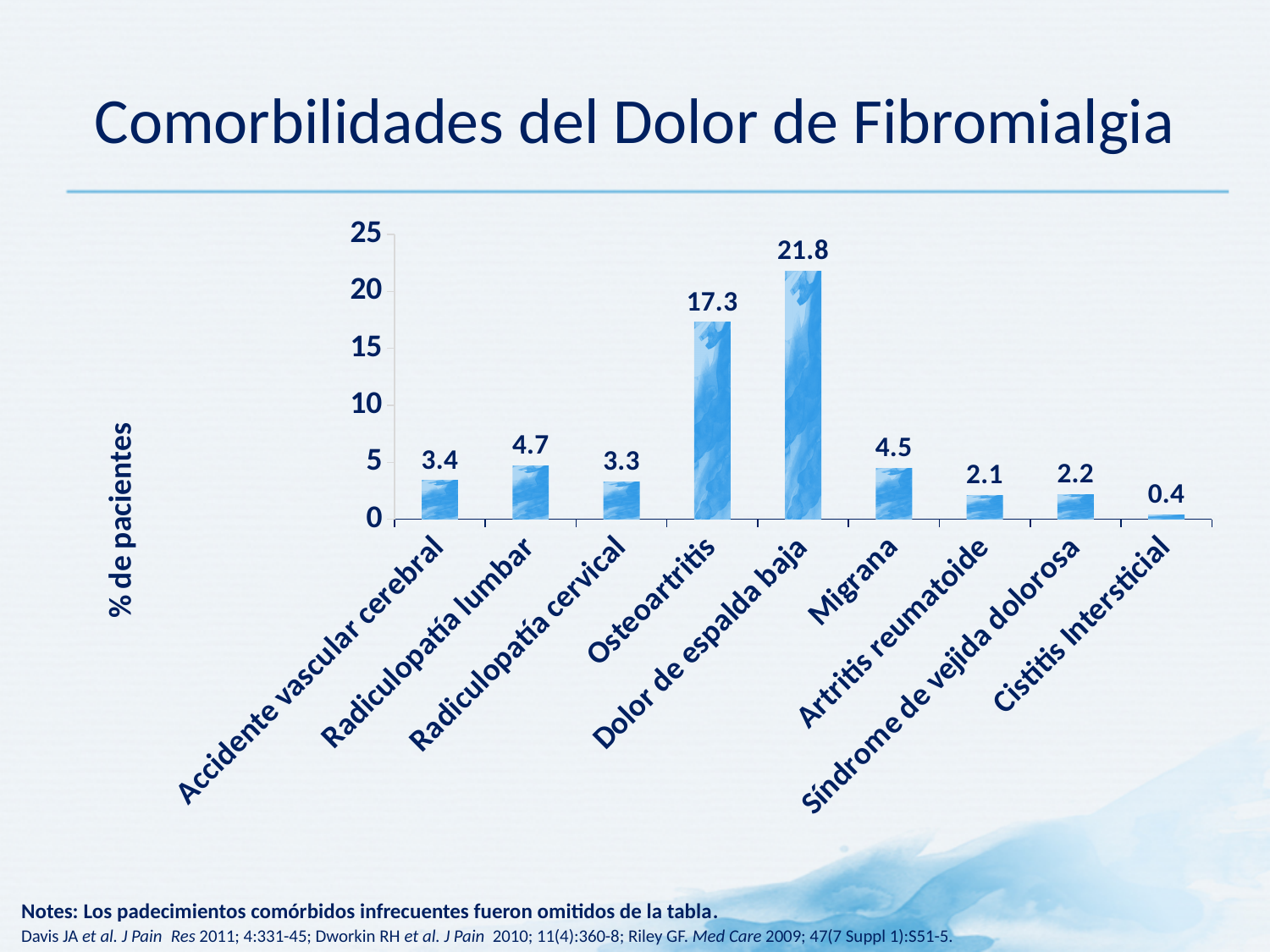
What is the difference between the values for Dolor de espalda baja and Osteoartritis? 4.5 How many categories are shown on the x axis? 9 Which is larger, the value for Radiculopatía lumbar or the value for Accidente vascular cerebral? Radiculopatía lumbar Which category has the lowest value? Cistitis Intersticial What is the value for Migrana? 4.5 Which category has the highest value? Dolor de espalda baja What is the label of the y axis? % de pacientes What kind of chart is shown on the slide? Bar chart What is the value for Osteoartritis? 17.3 Is the value for Dolor de espalda baja greater or less than 20? greater What is the title of the chart on the slide? Comorbilidades del Dolor de Fibromialgia What is the value for Cistitis Intersticial? 0.4